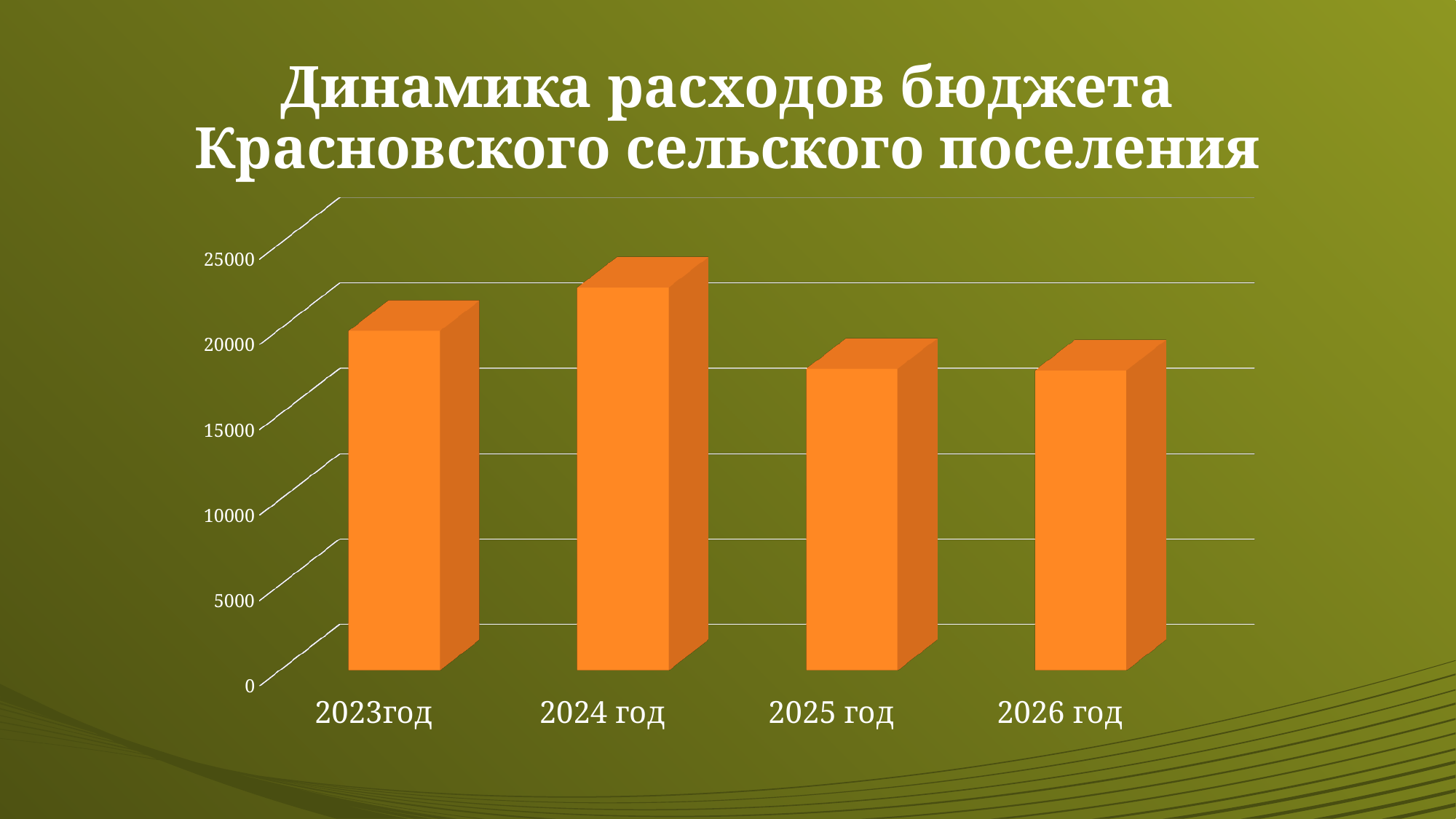
Is the value for 2024 год greater or less than 20000? greater How many years (categories) are shown on the x axis? 4 Which is larger, the value for 2023год or the value for 2025 год? 2023год Is the value for 2024 год greater or less than 25000? less Does the value rise or fall from 2024 год to 2025 год? fall Which year has the highest budget expenditure? 2024 год Is the value for 2023год greater or less than 15000? greater What is the title of the chart? Динамика расходов бюджета Красновского сельского поселения Which is larger, the value for 2023год or the value for 2024 год? 2024 год What kind of chart is shown on the slide? bar chart